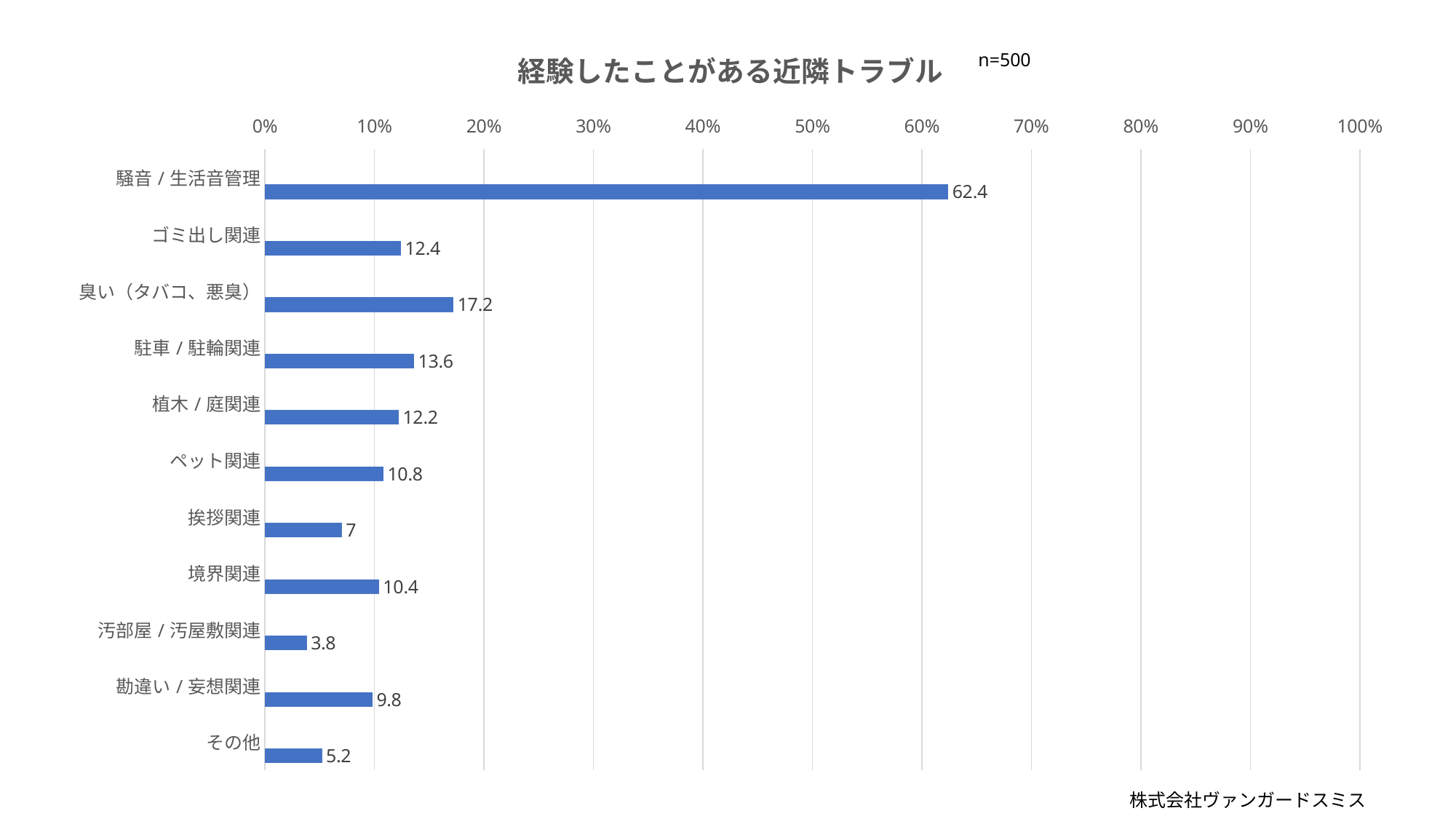
Which category has the highest value? 騒音 / 生活音管理 What is the value for 騒音 / 生活音管理? 62.4 What is the value for 汚部屋 / 汚屋敷関連? 3.8 What is the value for 勘違い / 妄想関連? 9.8 What is the difference between the values for 騒音 / 生活音管理 and 臭い（タバコ、悪臭）? 45.2 What is the value for 臭い（タバコ、悪臭）? 17.2 How many categories are shown in the chart? 11 What kind of chart is shown on the slide? bar chart Which category has the lowest value? 汚部屋 / 汚屋敷関連 Is the value for 騒音 / 生活音管理 greater or less than 50%? greater Which is larger, the value for 駐車 / 駐輪関連 or the value for ゴミ出し関連? 駐車 / 駐輪関連 What is the title of the chart? 経験したことがある近隣トラブル